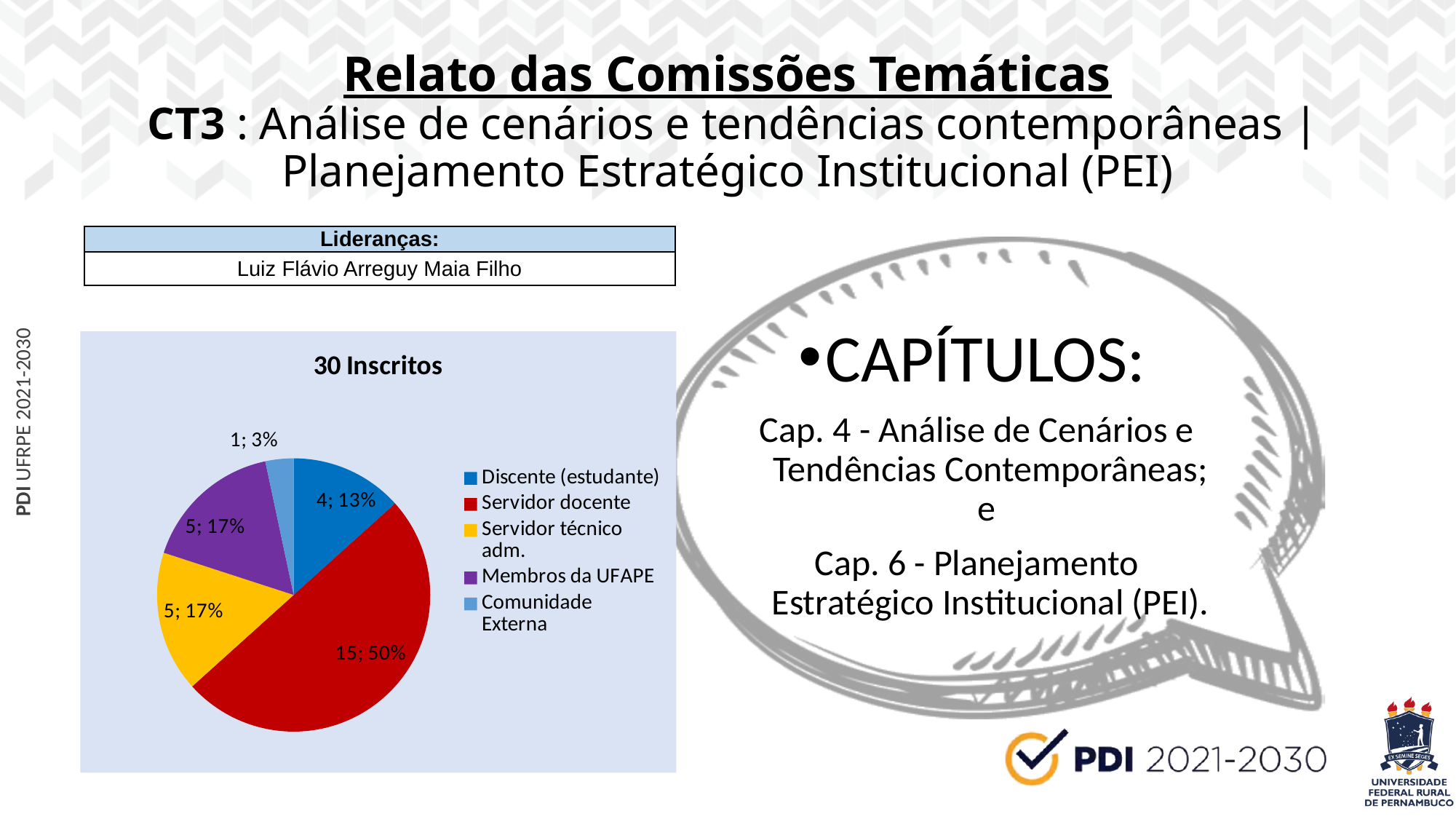
How many inscritos are in the Servidor docente category? 15 How many inscritos are in the Discente (estudante) category? 4 What is the title of the chart? 30 Inscritos What share of the pie does Servidor docente represent? 50% Which category has the smallest slice of the pie? Comunidade Externa What percentage of the pie is Comunidade Externa? 3% What kind of chart is shown on the slide? pie chart Which is larger, the count for Servidor docente or the count for Membros da UFAPE? Servidor docente How many entries does the chart legend list? 5 How many slices does the pie chart have? 5 What is the difference in count between Servidor docente and Discente (estudante)? 11 Which category has the largest slice of the pie? Servidor docente